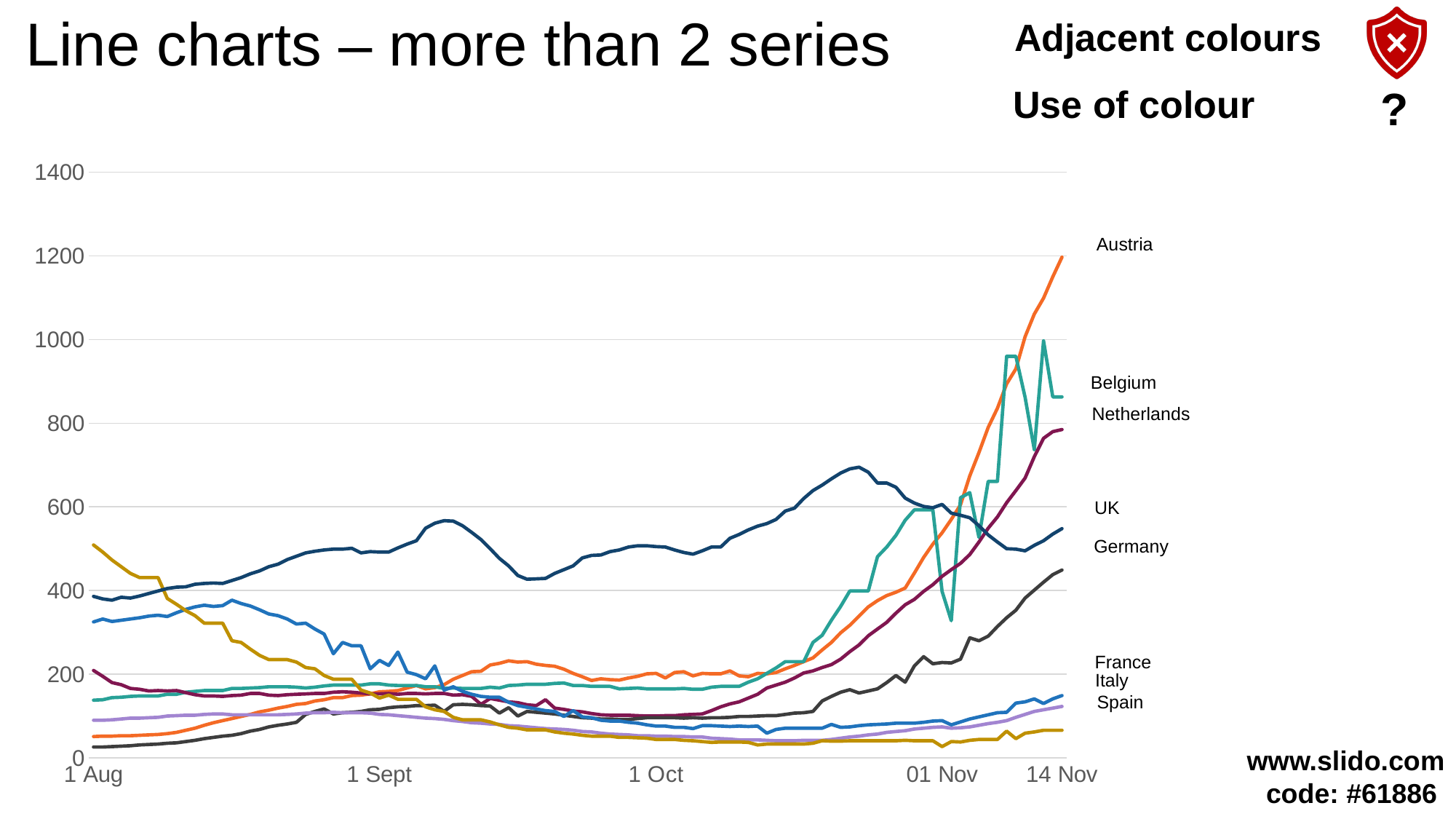
Which country has the lowest value at 14 Nov? Spain What is the title of the slide? Line charts – more than 2 series Is the value for Belgium at 14 Nov greater or less than 1000? less How many countries (series) are labelled on the chart? 8 Which country has the highest value at 14 Nov? Austria Does the value for Spain rise or fall between 1 Aug and 14 Nov? fall Is the value for France at 14 Nov greater or less than 200? less Is the value for UK at 14 Nov greater or less than 600? less Which is larger at 14 Nov, the value for Netherlands or the value for UK? Netherlands What kind of chart is shown on the slide? line chart